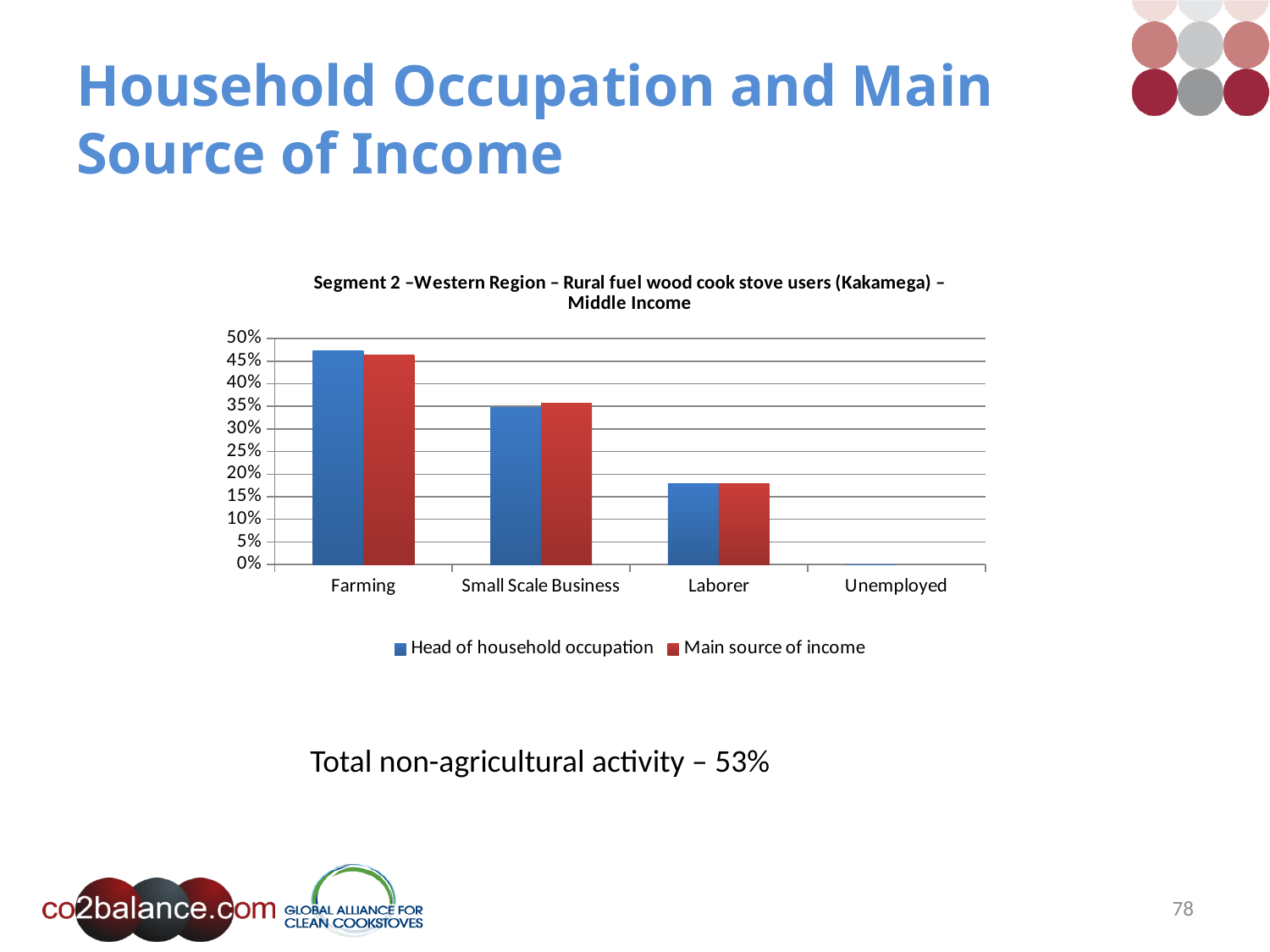
Is the Head of household occupation value for Farming greater or less than 45%? greater Which is larger: the Head of household occupation value for Farming or for Laborer? Farming What kind of chart is shown on the slide? bar chart Which category has the highest value for Head of household occupation? Farming Which category has the highest value for Main source of income? Farming What are the two series named in the chart's legend? Head of household occupation; Main source of income How many series does the chart's legend list? 2 Is the Main source of income value for Laborer greater or less than 20%? less Is the Head of household occupation value for Small Scale Business greater or less than 40%? less Do the Head of household occupation values rise or fall moving from Farming to Unemployed along the x axis? fall How many occupation categories are shown on the x axis of the chart? 4 Which category has the lowest value for Head of household occupation? Unemployed